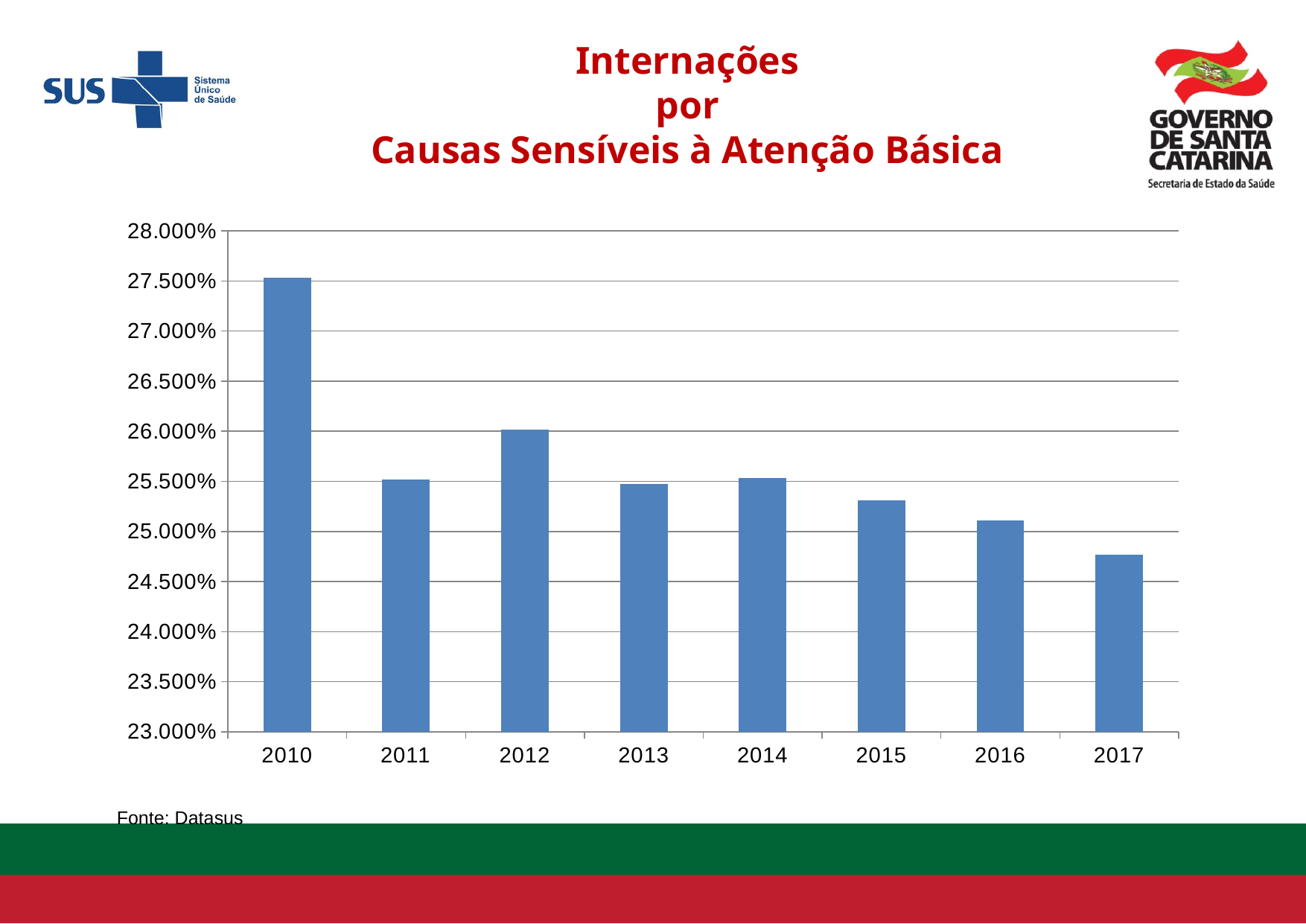
Is the value for 2011 greater or less than 26.000%? less Which year has the lowest value in the chart? 2017 Is the value for 2012 greater or less than 25.500%? greater Overall, do the values rise or fall from 2010 to 2017? Fall Which year has the highest value in the chart? 2010 Which year has the larger value, 2010 or 2012? 2010 Is the value for 2017 greater or less than 25.000%? less What source is cited below the chart? Datasus How many years are shown on the x axis of the chart? 8 Which year has the larger value, 2012 or 2015? 2012 What kind of chart is shown on the slide? Bar chart